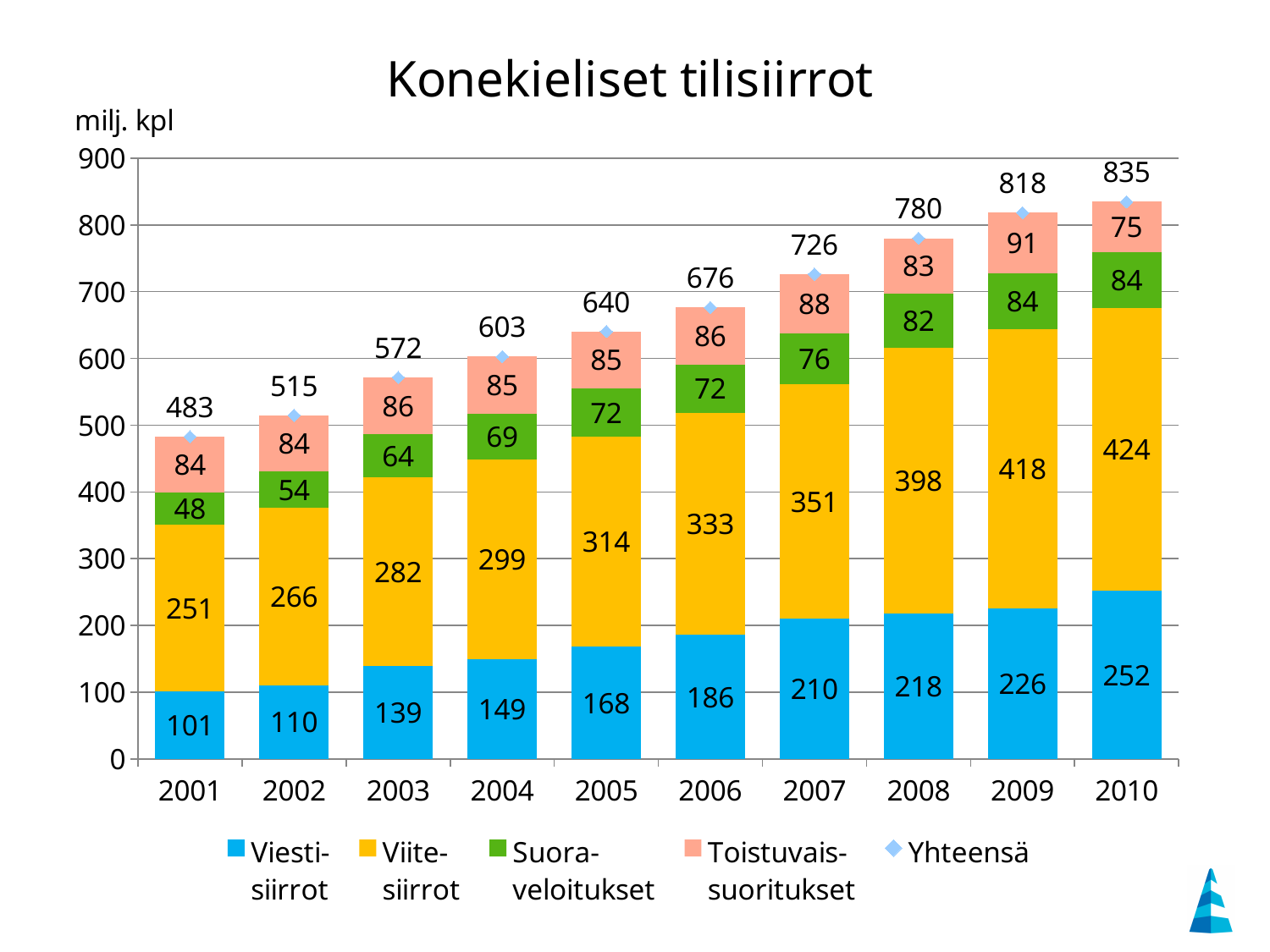
How many years are shown on the x axis? 10 Which year has the highest Yhteensä total? 2010 Which is larger: Toistuvaissuoritukset in 2009 or in 2010? 2009 What is the difference between the Viitesiirrot values for 2010 and 2001? 173 What is the Yhteensä total shown for 2008? 780 What is the title of the chart? Konekieliset tilisiirrot Which year has the lowest value for Viestisiirrot? 2001 Do the Yhteensä totals rise or fall from 2001 to 2010? Rise What kind of chart is shown? Stacked bar chart What is the value for Viitesiirrot in 2005? 314 What is the value for Suoraveloitukset in 2003? 64 How many series does the legend list? 5